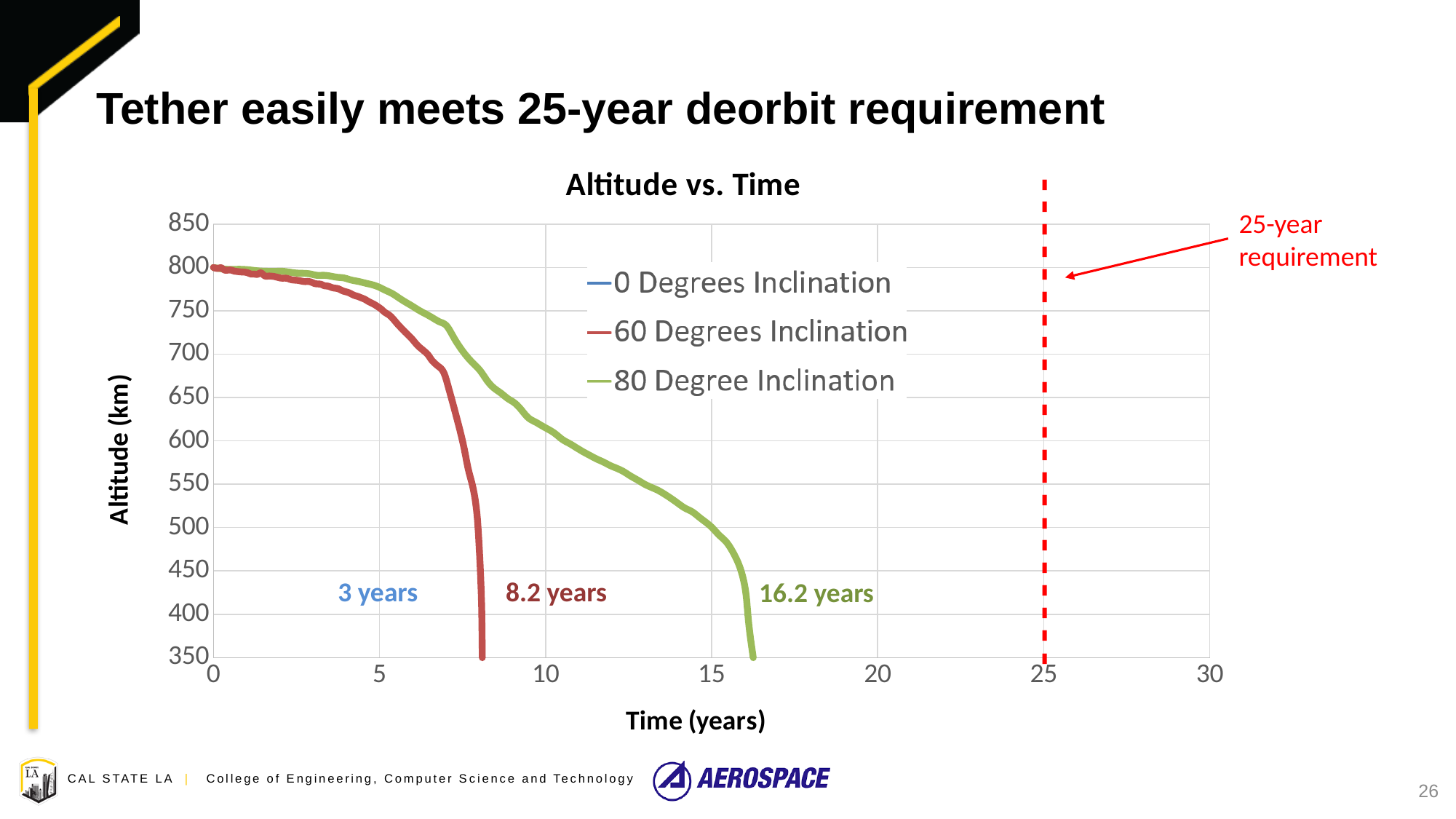
According to the annotation on the chart, how many years does the 80 Degree Inclination case take to deorbit? 16.2 years Is the altitude of the 60 Degrees Inclination line at 7 years greater or less than 700? less What is the label of the y axis? Altitude (km) According to the annotation on the chart, how many years does the 60 Degrees Inclination case take to deorbit? 8.2 years What is the title of the chart? Altitude vs. Time Which inclination case has the shortest deorbit time? 0 Degrees Inclination What kind of chart is shown on the slide? Line chart Do the altitude curves rise or fall as time increases? Fall How many series does the chart legend list? 3 According to the annotation on the chart, how many years does the 0 Degrees Inclination case take to deorbit? 3 years Which inclination case has the longest deorbit time? 80 Degree Inclination How many years longer does the 80 Degree Inclination case take to deorbit than the 60 Degrees Inclination case? 8 years